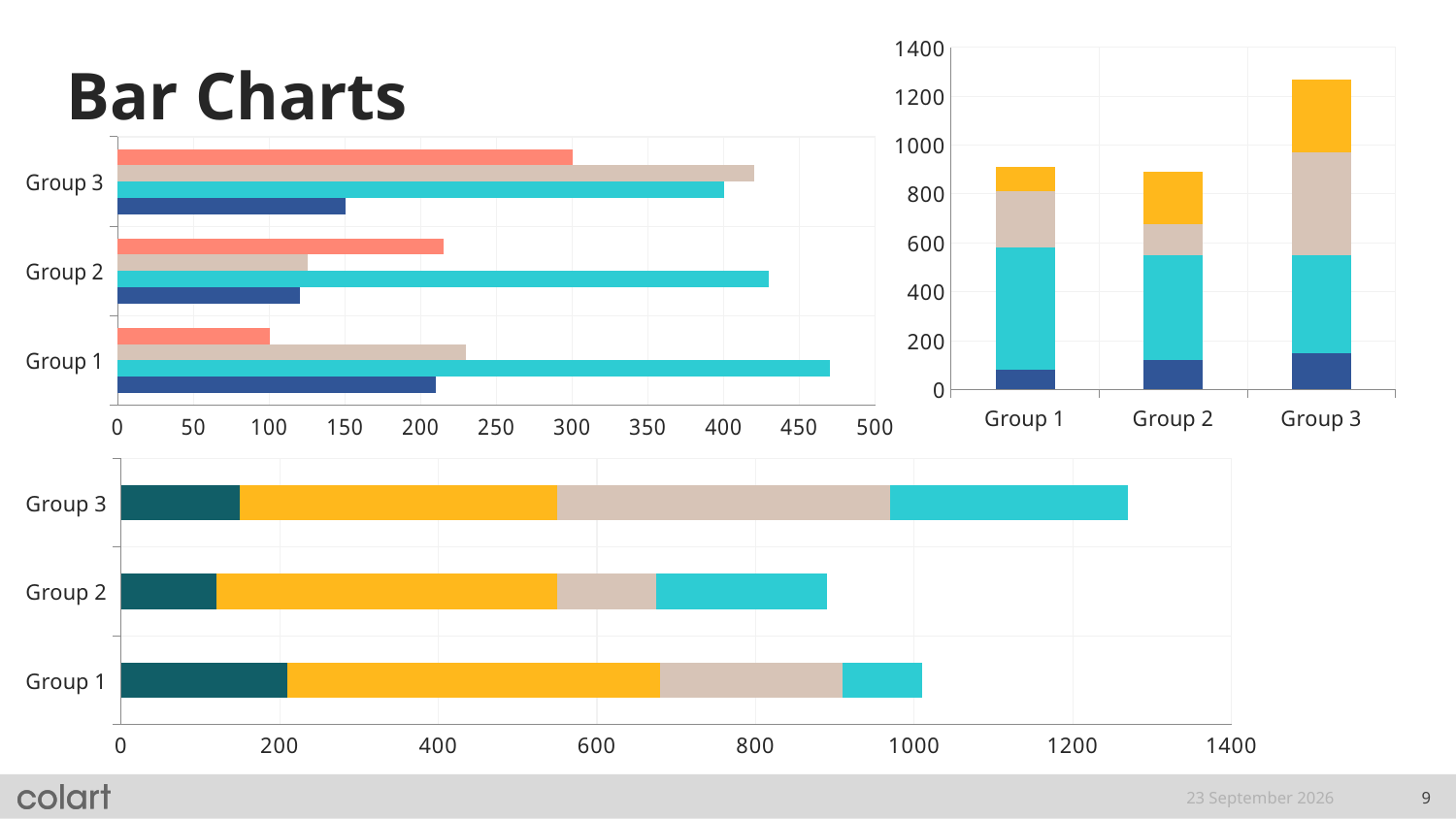
On the top-left chart, is the salmon-coloured bar for Group 3 greater or less than 250? greater On the bottom chart, which group has the shortest stacked bar? Group 2 On the top-right chart, is the total for Group 3 greater or less than 1200? greater On the bottom chart, which group has the longest stacked bar? Group 3 On the top-right chart, which group has the tallest stacked bar? Group 3 How many bars are plotted for each group on the top-left chart? 4 On the top-left chart, is the longest bar for Group 1 greater or less than 450? greater What kind of chart is the top-left chart? bar chart How many groups are shown on the top-left chart? 3 How many segments make up each stacked bar on the top-right chart? 4 What kind of chart is the bottom chart? bar chart